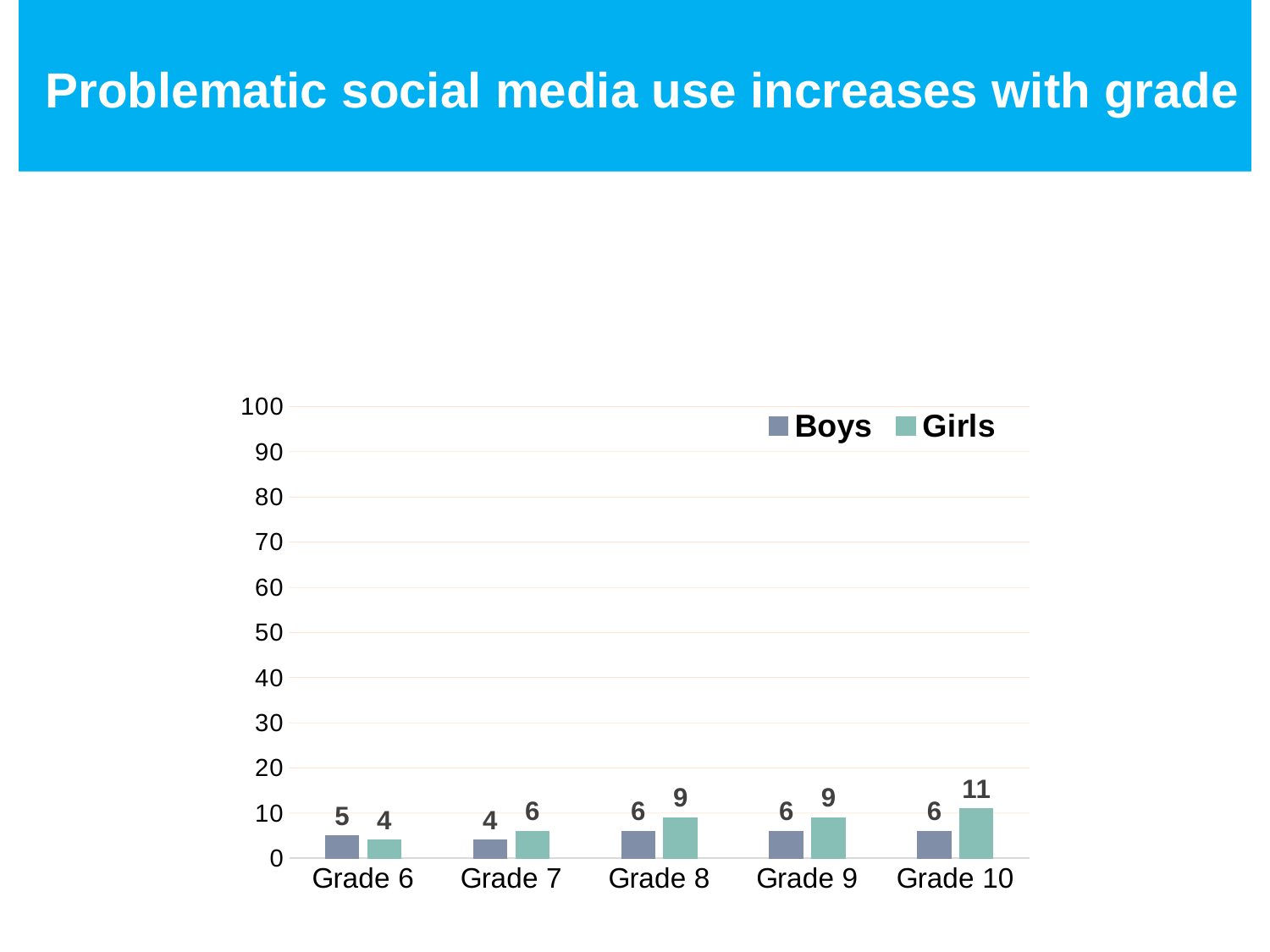
Do the Girls values generally rise or fall from Grade 6 to Grade 10? rise How many series does the legend list? 2 What is the value for Girls in Grade 7? 6 What is the difference between the Girls and Boys values in Grade 10? 5 How many grade categories are shown on the x axis? 5 In Grade 6, which is larger, the value for Boys or for Girls? Boys Is the value for Girls in Grade 10 greater or less than 20? less Which grade has the highest value for Girls? Grade 10 What kind of chart is shown on the slide? bar chart What is the value for Girls in Grade 10? 11 What is the value for Boys in Grade 6? 5 Which grade has the lowest value for Boys? Grade 7